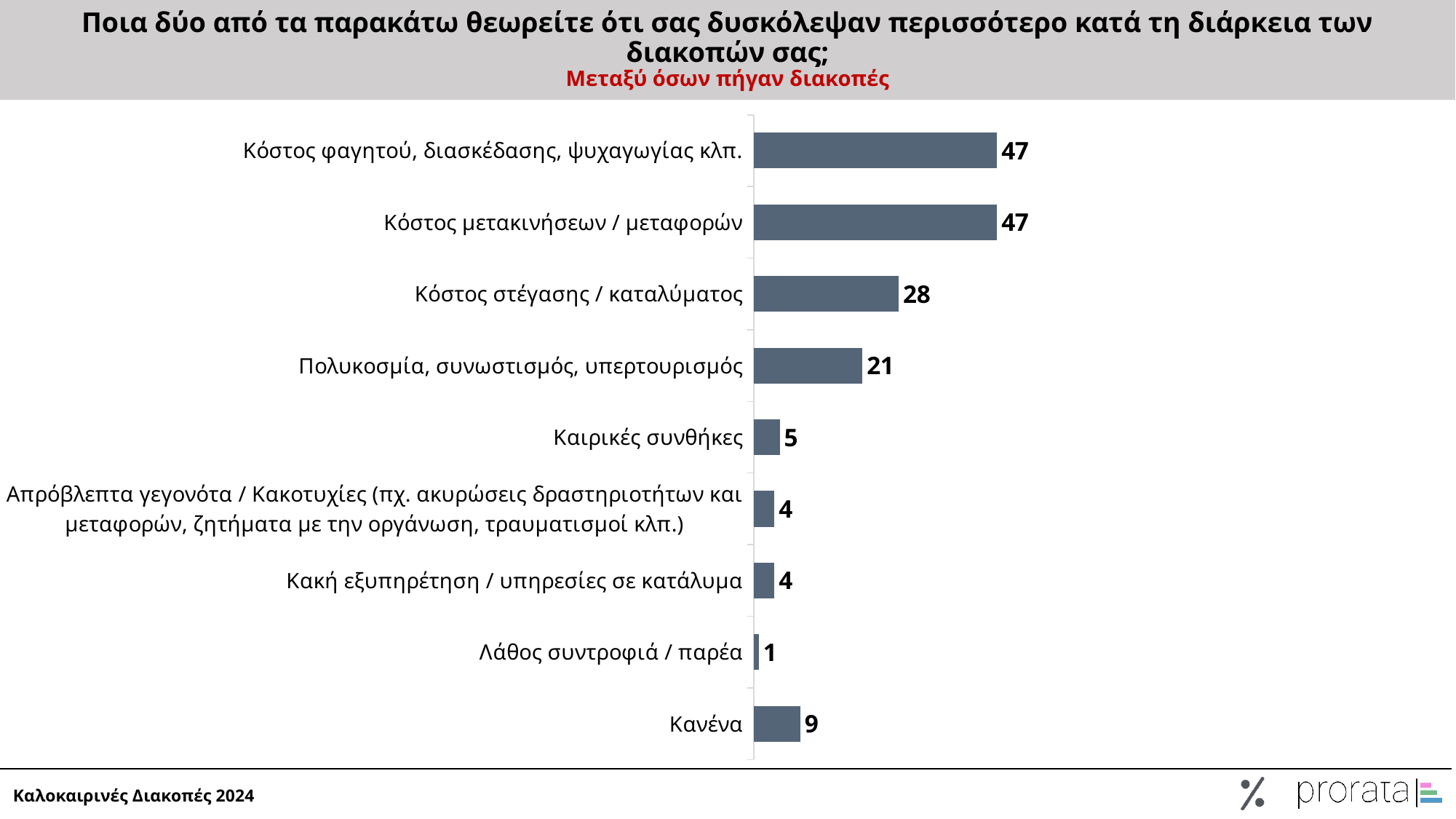
What is the value for "Κόστος στέγασης / καταλύματος"? 28 What is the value for "Κανένα"? 9 What is the red subtitle text below the chart title? Μεταξύ όσων πήγαν διακοπές Which is larger: the value for "Κανένα" or the value for "Καιρικές συνθήκες"? Κανένα How many categories are shown in the chart? 9 What is the value for "Πολυκοσμία, συνωστισμός, υπερτουρισμός"? 21 What is the highest value shown in the chart? 47 What is the value for "Καιρικές συνθήκες"? 5 What is the difference between the values for "Πολυκοσμία, συνωστισμός, υπερτουρισμός" and "Κανένα"? 12 What is the difference between the values for "Κόστος μετακινήσεων / μεταφορών" and "Κόστος στέγασης / καταλύματος"? 19 Which category has the lowest value? Λάθος συντροφιά / παρέα What type of chart is shown on the slide? Bar chart